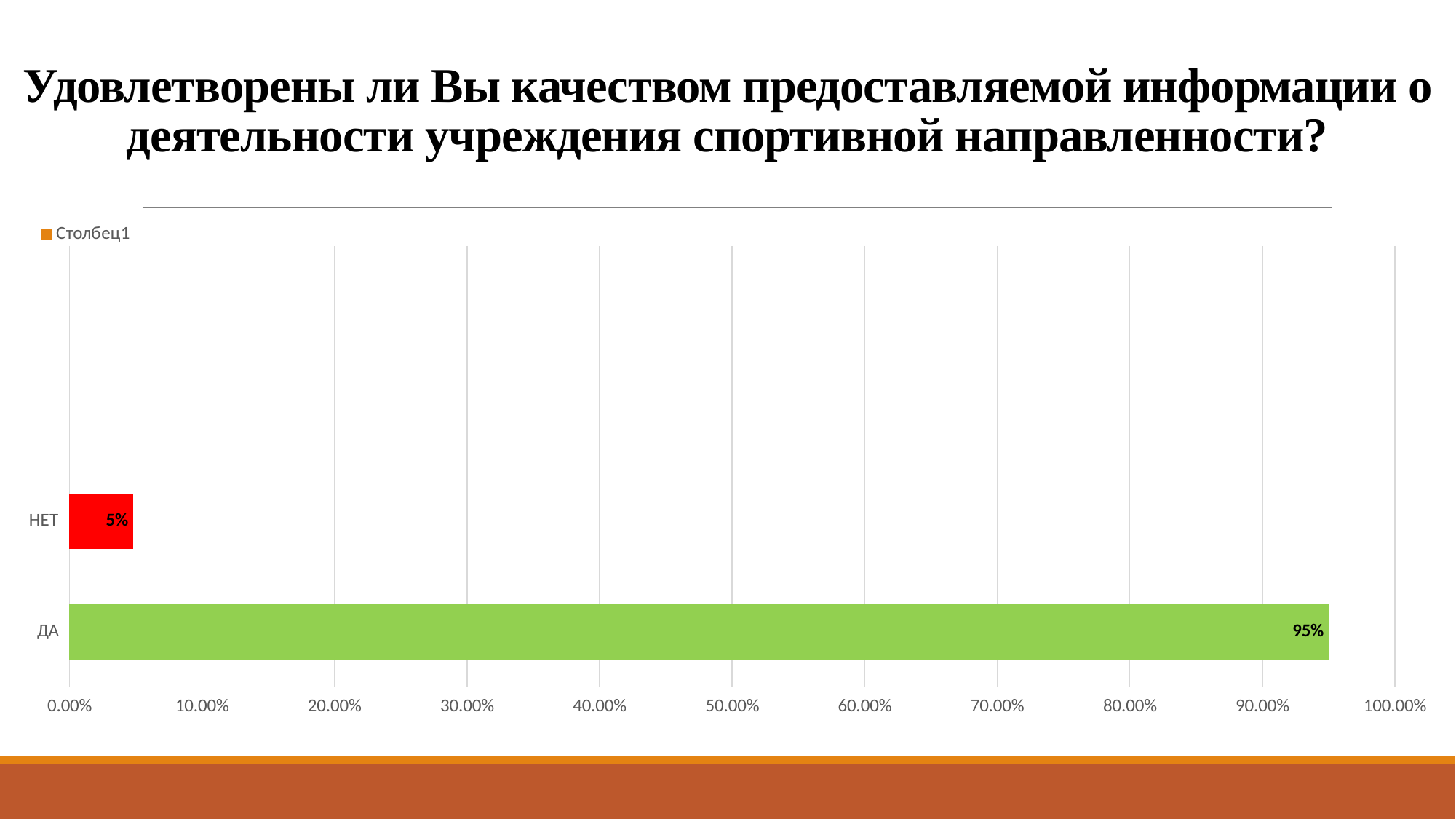
What is the value for НЕТ? 5% How many categories are shown in the chart? 2 Which category has the lowest value? НЕТ What is the legend entry shown on the chart? Столбец1 Is the value for НЕТ greater or less than 10.00%? less Is the value for ДА greater or less than 90.00%? greater What is the difference between the values for ДА and НЕТ? 90% How many series does the legend list? 1 What is the value for ДА? 95% Which is larger, the value for ДА or the value for НЕТ? ДА What kind of chart is shown on the slide? bar chart Which category has the highest value? ДА